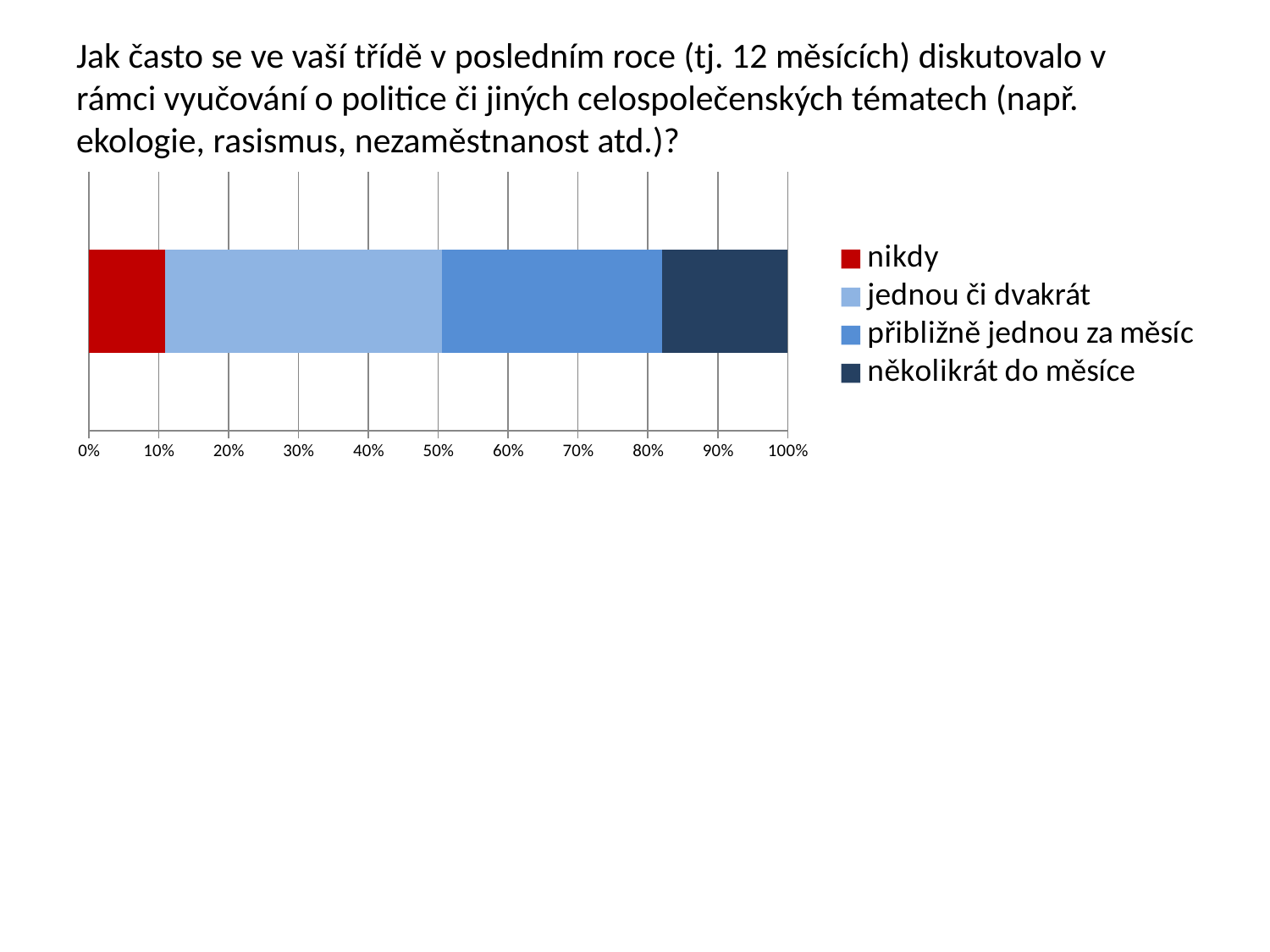
What kind of chart is shown on the slide? stacked bar chart How many series does the legend list? 4 Is the value for 'jednou či dvakrát' greater or less than 30%? greater Which legend entry is shown in red? nikdy Which segment of the stacked bar is the largest? jednou či dvakrát Is the value for 'nikdy' greater or less than 20%? less Is the value for 'přibližně jednou za měsíc' greater or less than 40%? less What is the highest value shown on the horizontal axis? 100% Which segment is larger, 'jednou či dvakrát' or 'přibližně jednou za měsíc'? jednou či dvakrát Which segment is larger, 'nikdy' or 'několikrát do měsíce'? několikrát do měsíce Which segment of the stacked bar is the smallest? nikdy